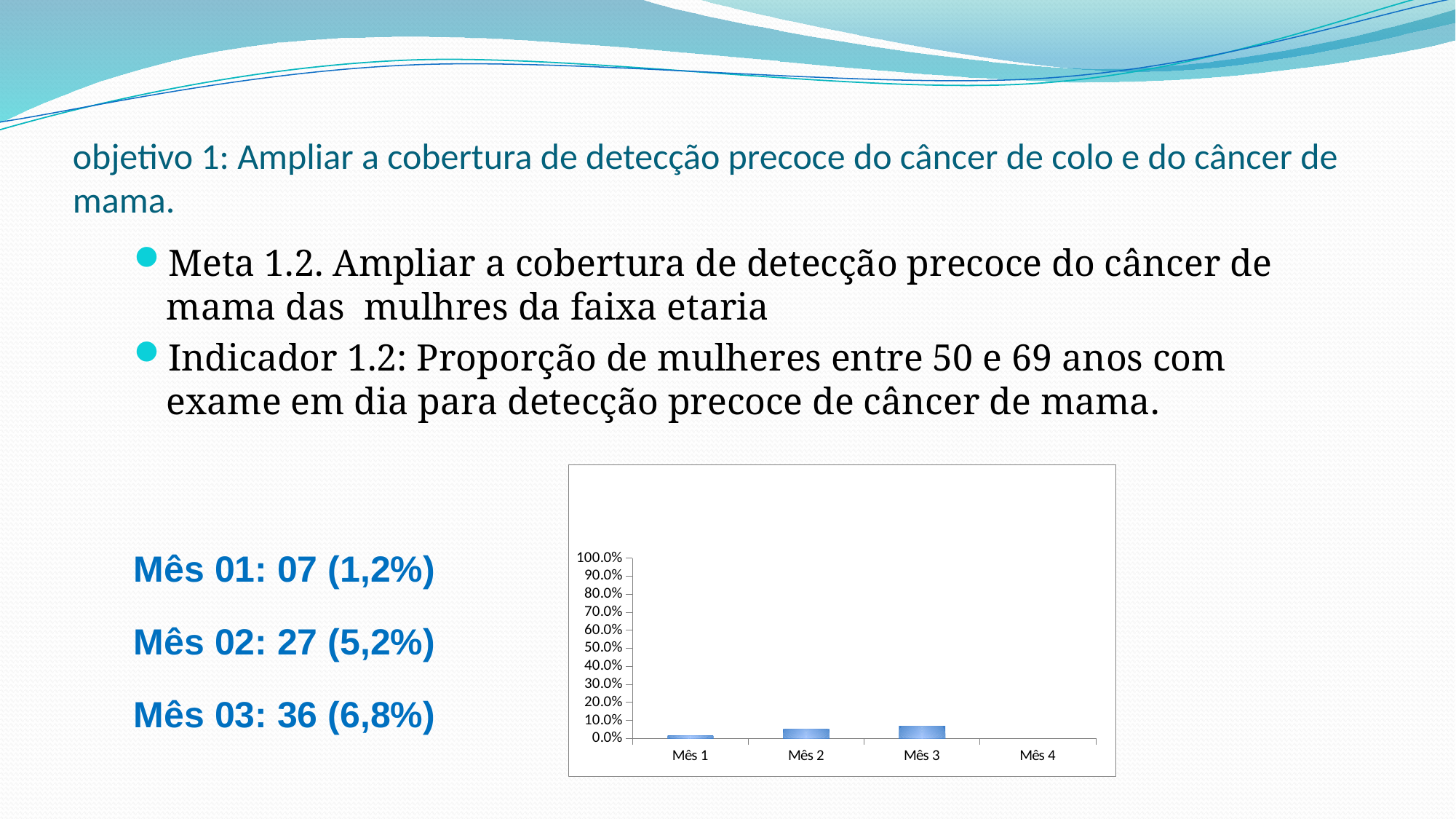
What kind of chart is shown on the slide? bar chart Which bar is taller, Mês 2 or Mês 3? Mês 3 Which month has the tallest bar in the chart? Mês 3 Is the bar for Mês 2 greater or less than 20.0%? less Which month has the shortest visible bar in the chart? Mês 1 According to the text on the slide, what percentage is given for Mês 03? 6,8% What is the highest value shown on the chart's y axis? 100.0% Which month on the x axis has no visible bar? Mês 4 How many categories are shown on the x axis of the chart? 4 Which bar is taller, Mês 1 or Mês 2? Mês 2 Do the bar values rise or fall from Mês 1 to Mês 3? rise Is the bar for Mês 3 greater or less than 10.0%? less